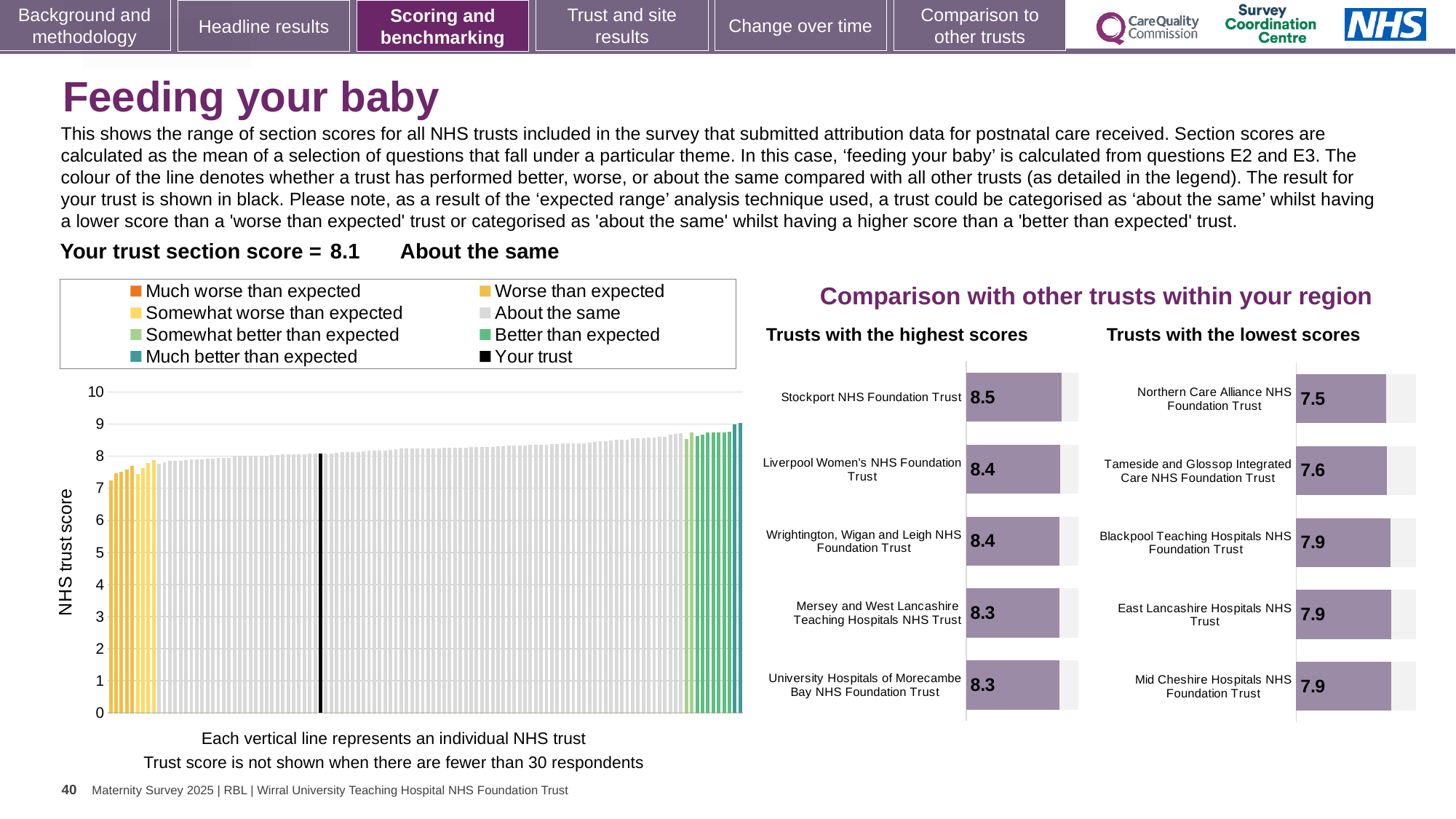
In the 'Trusts with the lowest scores' chart, which has the larger score: Tameside and Glossop Integrated Care NHS Foundation Trust or Northern Care Alliance NHS Foundation Trust? Tameside and Glossop Integrated Care NHS Foundation Trust In the 'Trusts with the lowest scores' chart, which trust has the lowest score? Northern Care Alliance NHS Foundation Trust In the main 'NHS trust score' chart on the left, do the bar values rise or fall from left to right along the x axis? Rise How many entries does the legend of the main 'NHS trust score' chart list? 8 In the 'Trusts with the highest scores' chart, what is the difference between the scores of Stockport NHS Foundation Trust and University Hospitals of Morecambe Bay NHS Foundation Trust? 0.2 In the 'Trusts with the lowest scores' chart, what is the difference between the scores of Blackpool Teaching Hospitals NHS Foundation Trust and Northern Care Alliance NHS Foundation Trust? 0.4 In the 'Trusts with the highest scores' chart, what is the score for Stockport NHS Foundation Trust? 8.5 In the main 'NHS trust score' chart on the left, is the value of the leftmost (lowest) bar greater or less than 8? less In the 'Trusts with the lowest scores' chart, what is the score for Tameside and Glossop Integrated Care NHS Foundation Trust? 7.6 In the main 'NHS trust score' chart on the left, what kind of chart is it? Bar chart How many trusts are shown in the 'Trusts with the highest scores' chart? 5 In the 'Trusts with the highest scores' chart, which trust has the highest score? Stockport NHS Foundation Trust